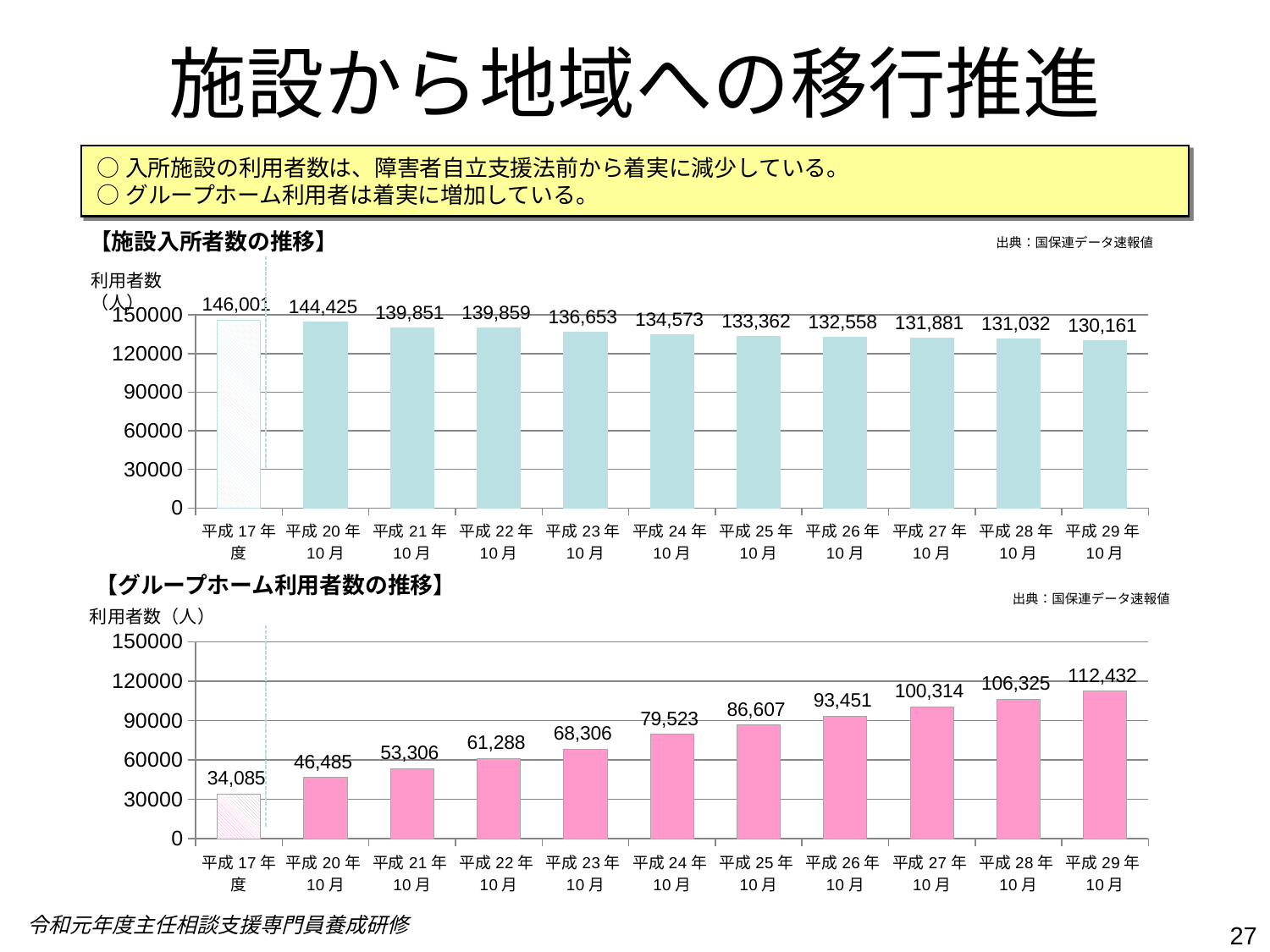
In the 【グループホーム利用者数の推移】 chart, what is the difference between the values for 平成29年10月 and 平成28年10月? 6,107 In the 【施設入所者数の推移】 chart, what is the value for 平成29年10月? 130,161 In the 【グループホーム利用者数の推移】 chart, what is the value for 平成27年10月? 100,314 In the 【グループホーム利用者数の推移】 chart, what is the value for 平成17年度? 34,085 In the 【グループホーム利用者数の推移】 chart, which category has the lowest value? 平成17年度 In the 【施設入所者数の推移】 chart, how many bars are plotted? 11 In the 【施設入所者数の推移】 chart, do the values generally rise or fall from left to right? fall In the 【施設入所者数の推移】 chart, what is the value for 平成23年10月? 136,653 In the 【グループホーム利用者数の推移】 chart, is the value for 平成24年10月 greater or less than 90000? less In the 【施設入所者数の推移】 chart, what is the difference between the values for 平成20年10月 and 平成29年10月? 14,264 What type of chart is the 【グループホーム利用者数の推移】 chart? bar chart In the 【グループホーム利用者数の推移】 chart, which category has the highest value? 平成29年10月